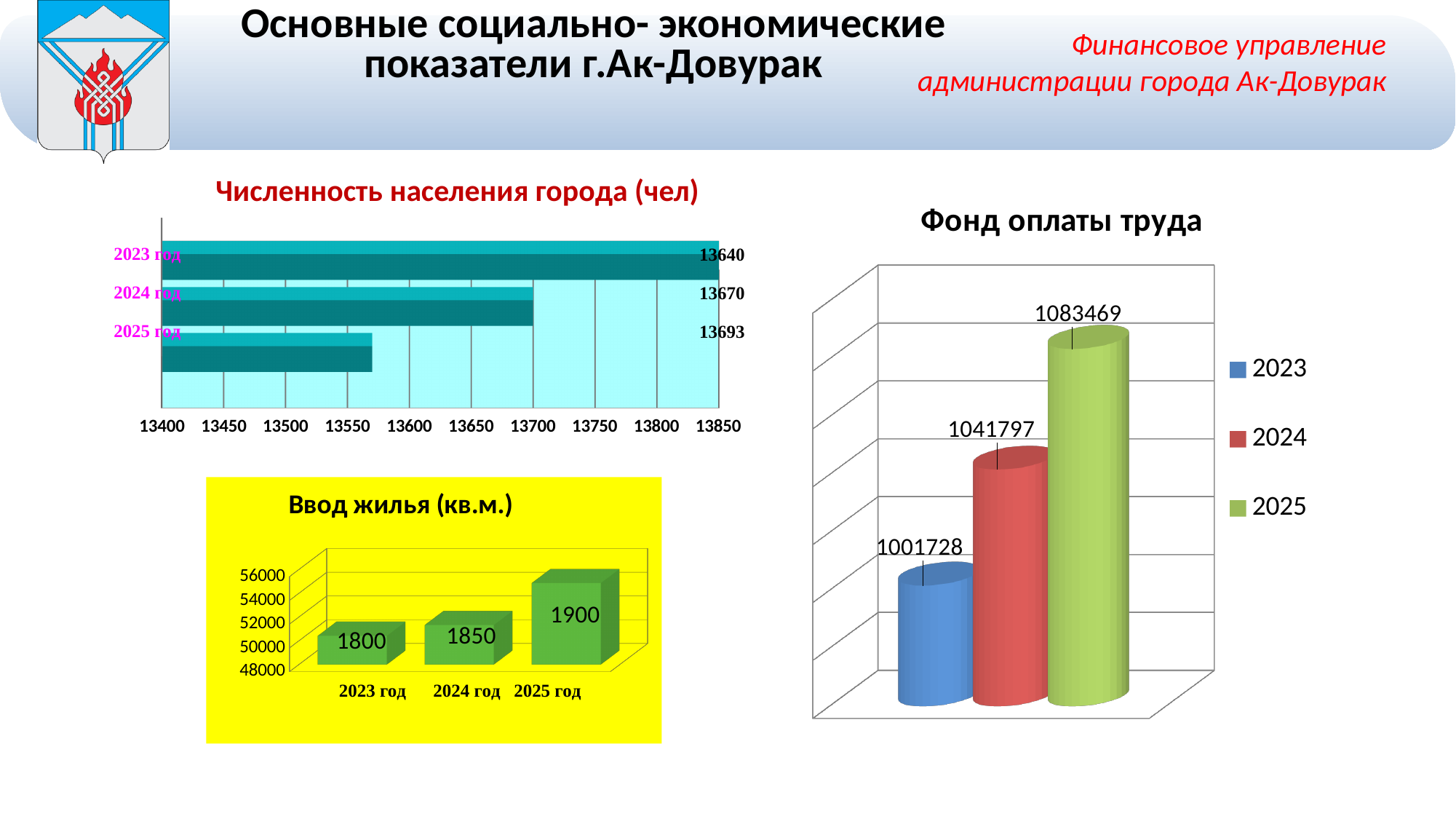
In the chart titled 'Численность населения города (чел)', what is the difference between the values for 2025 год and 2023 год? 53 In the chart titled 'Фонд оплаты труда', how many entries does the legend list? 3 In the chart titled 'Фонд оплаты труда', what is the value for 2024? 1041797 In the chart titled 'Численность населения города (чел)', how many categories are shown? 3 In the chart titled 'Численность населения города (чел)', what is the value for 2025 год? 13693 In the chart titled 'Ввод жилья (кв.м.)', what is the difference between the values for 2025 год and 2023 год? 100 In the chart titled 'Фонд оплаты труда', what is the difference between the values for 2025 and 2023? 81741 In the chart titled 'Фонд оплаты труда', which year has the lowest value? 2023 In the chart titled 'Ввод жилья (кв.м.)', do the values rise or fall from 2023 год to 2025 год? rise In the chart titled 'Численность населения города (чел)', what is the value for 2023 год? 13640 In the chart titled 'Ввод жилья (кв.м.)', which year has the highest value? 2025 год In the chart titled 'Ввод жилья (кв.м.)', what is the value for 2024 год? 1850